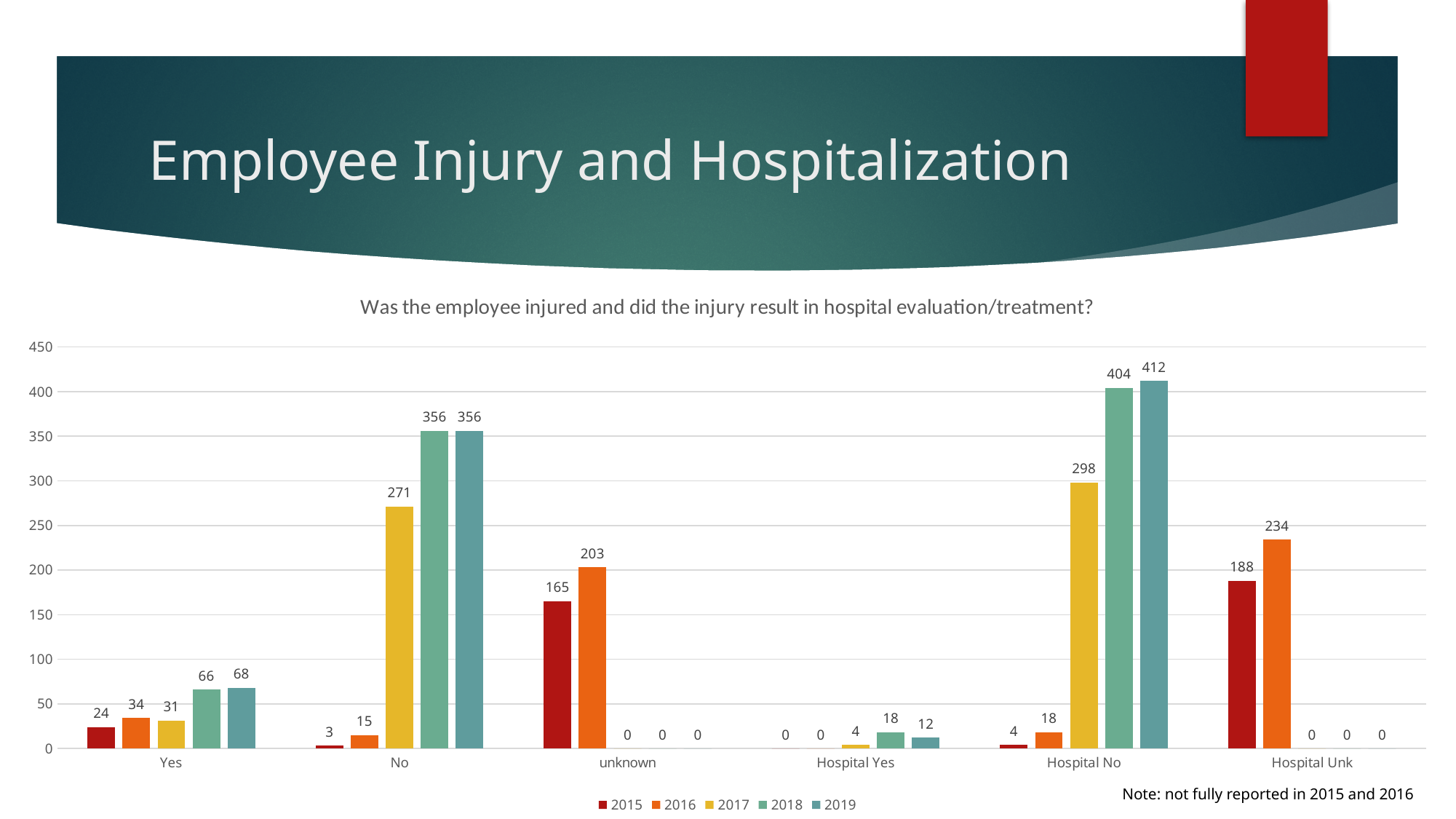
What is the value for 2017 in the No category? 271 How many categories are shown on the x axis? 6 Which year has the lowest value in the No category? 2015 What kind of chart is shown on the slide? bar chart Which year has the highest value in the Hospital No category? 2019 What is the difference between the 2018 and 2017 values in the Hospital No category? 106 What is the title of the chart? Was the employee injured and did the injury result in hospital evaluation/treatment? What is the value for 2019 in the Hospital No category? 412 What is the value for 2016 in the Hospital Unk category? 234 What is the difference between the 2016 and 2015 values in the unknown category? 38 How many series does the legend list? 5 Which is larger: the 2018 value for Yes or the 2019 value for Yes? 2019